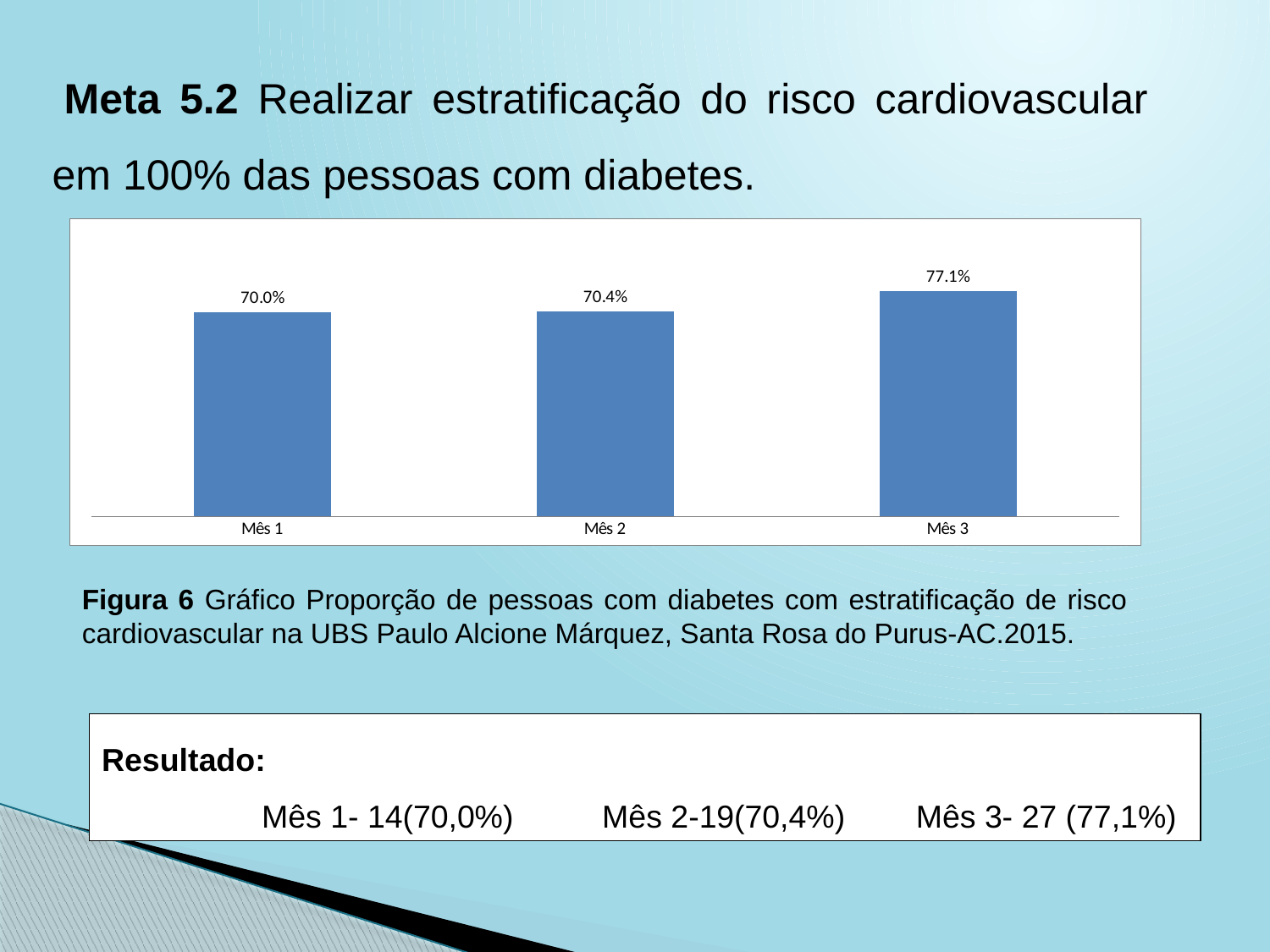
Which month has the lowest value? Mês 1 What is the difference between the values for Mês 3 and Mês 2? 6.7% What is the difference between the values for Mês 3 and Mês 1? 7.1% Which month has the highest value? Mês 3 What kind of chart is shown on the slide? Bar chart What is the value for Mês 1? 70.0% What is the value for Mês 3? 77.1% What is the value for Mês 2? 70.4% What colour are the bars in the chart? Blue Which is larger, the value for Mês 3 or the value for Mês 2? Mês 3 Do the values rise or fall from Mês 1 to Mês 3? Rise How many categories are shown on the x axis? 3